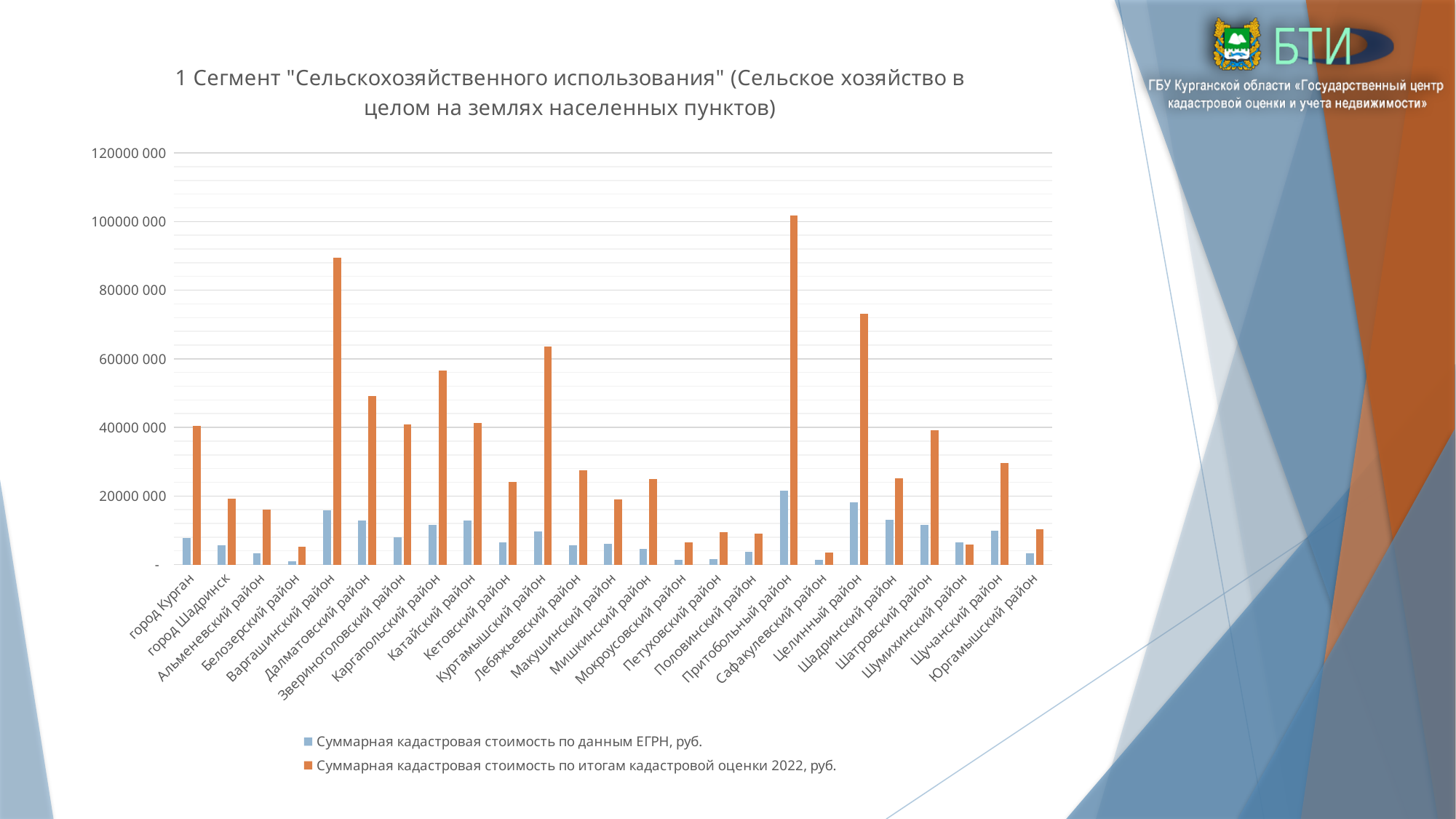
What colour are the bars for 'Суммарная кадастровая стоимость по данным ЕГРН, руб.'? Blue Which category has the highest value for 'Суммарная кадастровая стоимость по итогам кадастровой оценки 2022, руб.'? Притобольный район Which category has the highest value for 'Суммарная кадастровая стоимость по данным ЕГРН, руб.'? Притобольный район Is the 2022 cadastral valuation value for Притобольный район greater or less than 100000 000? greater Is the 2022 cadastral valuation value for Каргапольский район greater or less than 60000 000? less Is the ЕГРН value for Целинный район greater or less than 20000 000? less Which is larger for the 2022 cadastral valuation series: Далматовский район or Каргапольский район? Каргапольский район How many series does the legend list? 2 Which is larger for the 2022 cadastral valuation series: Варгашинский район or Целинный район? Варгашинский район What kind of chart is shown on the slide? Bar chart How many categories (municipalities) are shown along the x axis? 25